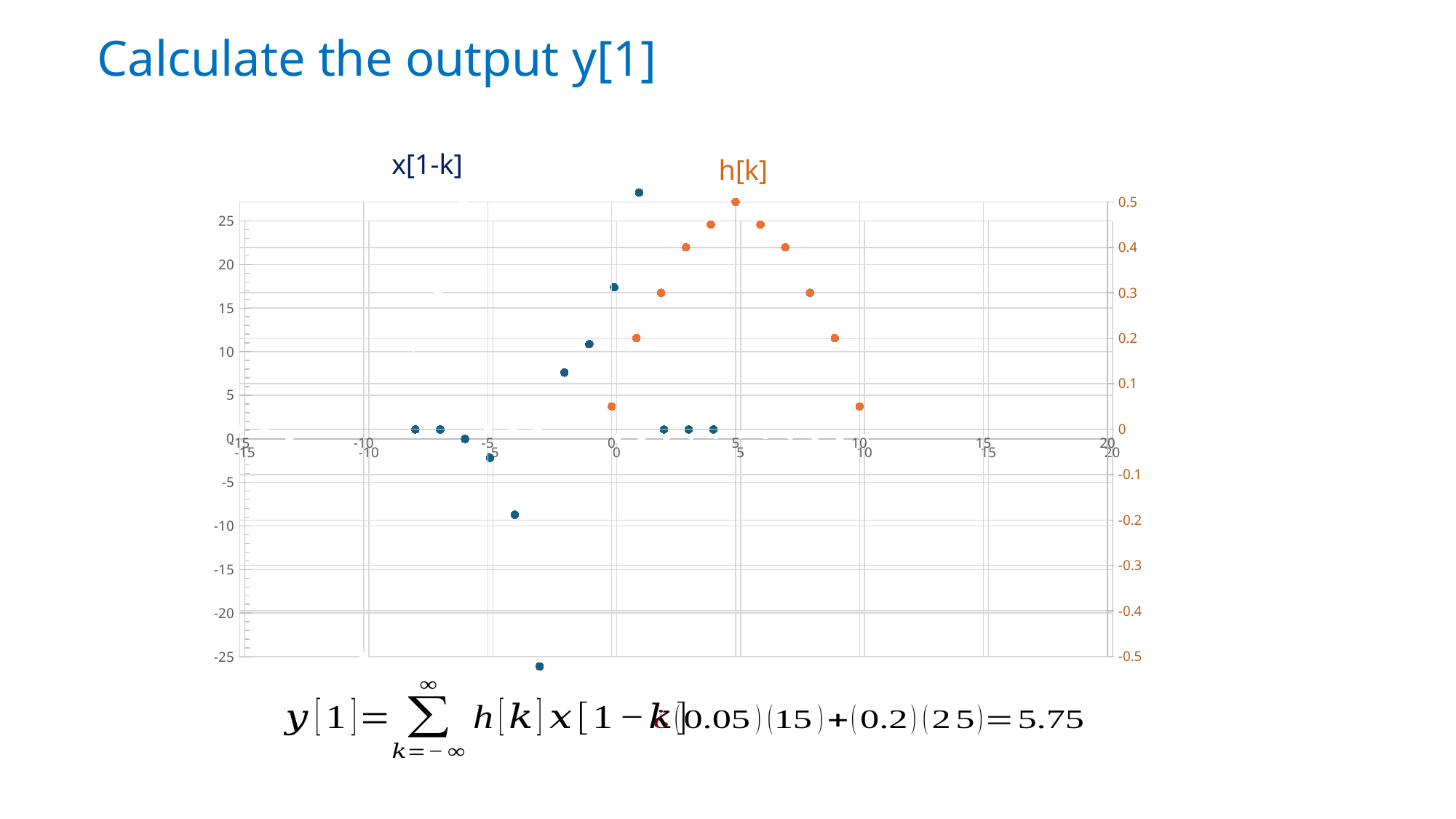
At which value of k does the x[1-k] series reach its lowest point? -3 How many points are plotted for the h[k] series? 11 At which value of k does the h[k] series reach its highest point? 5 What are the names of the two series plotted on the chart? x[1-k] and h[k] What kind of chart is shown on the slide? scatter chart Which is larger, h[k] at k=1 or h[k] at k=2? h[k] at k=2 At which value of k does the x[1-k] series reach its highest point? 1 Is the value of h[k] at k=4 greater or less than 0.4 on the right axis? greater How many series are plotted on the chart? 2 Is the value of x[1-k] at k=-3 greater or less than -20 on the left axis? less Which colour is used for the h[k] series? orange